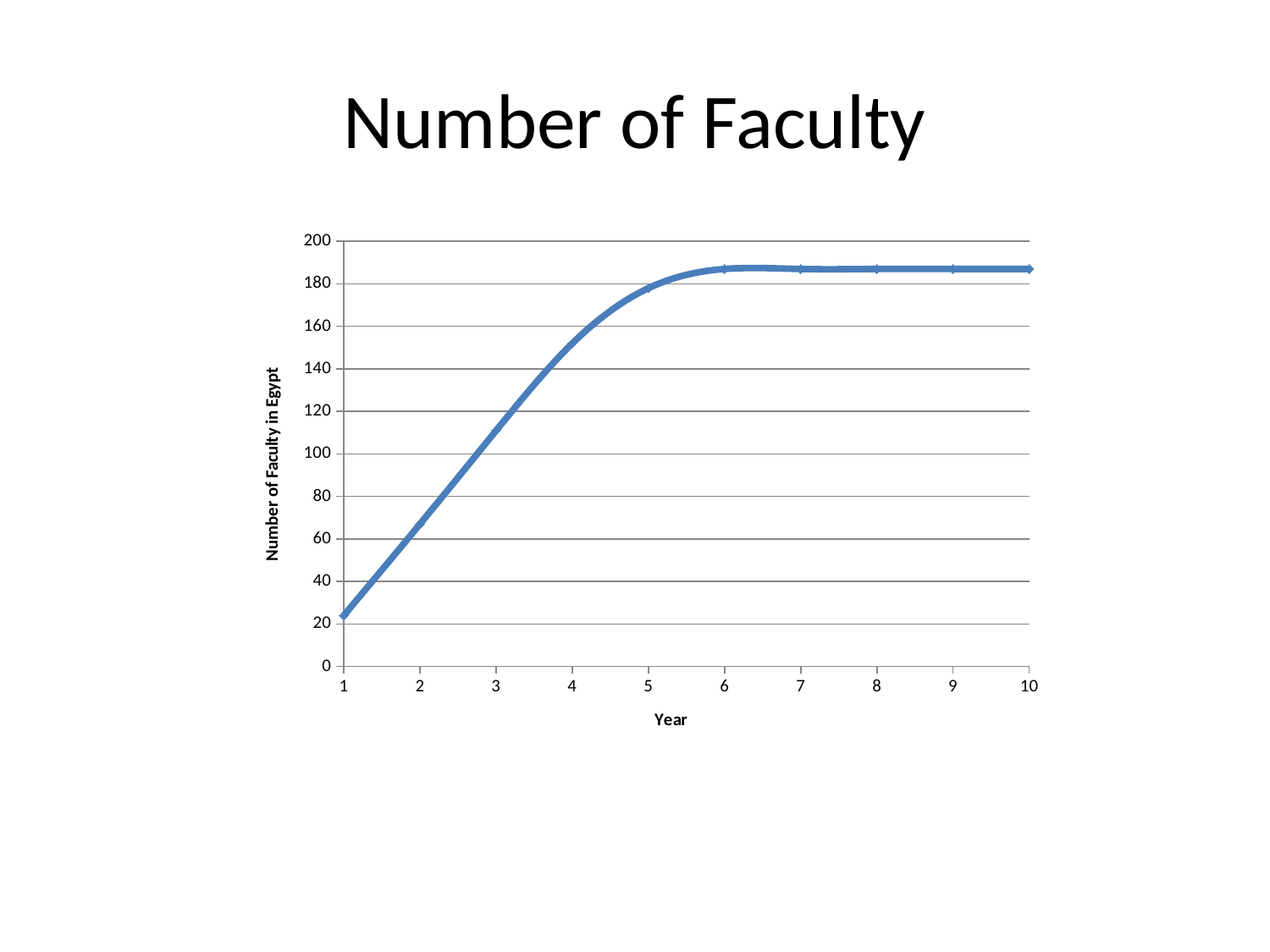
Is the value for year 8 greater or less than 180? greater Is the value for year 2 greater or less than 60? greater Is the value for year 3 larger or smaller than the value for year 5? smaller Which year has the lowest number of faculty? 1 What kind of chart is shown on the slide? line chart How many years are plotted along the x axis? 10 Is the value for year 1 greater or less than 40? less What is the title of the y axis? Number of Faculty in Egypt Do the values rise or fall from year 1 to year 5? rise